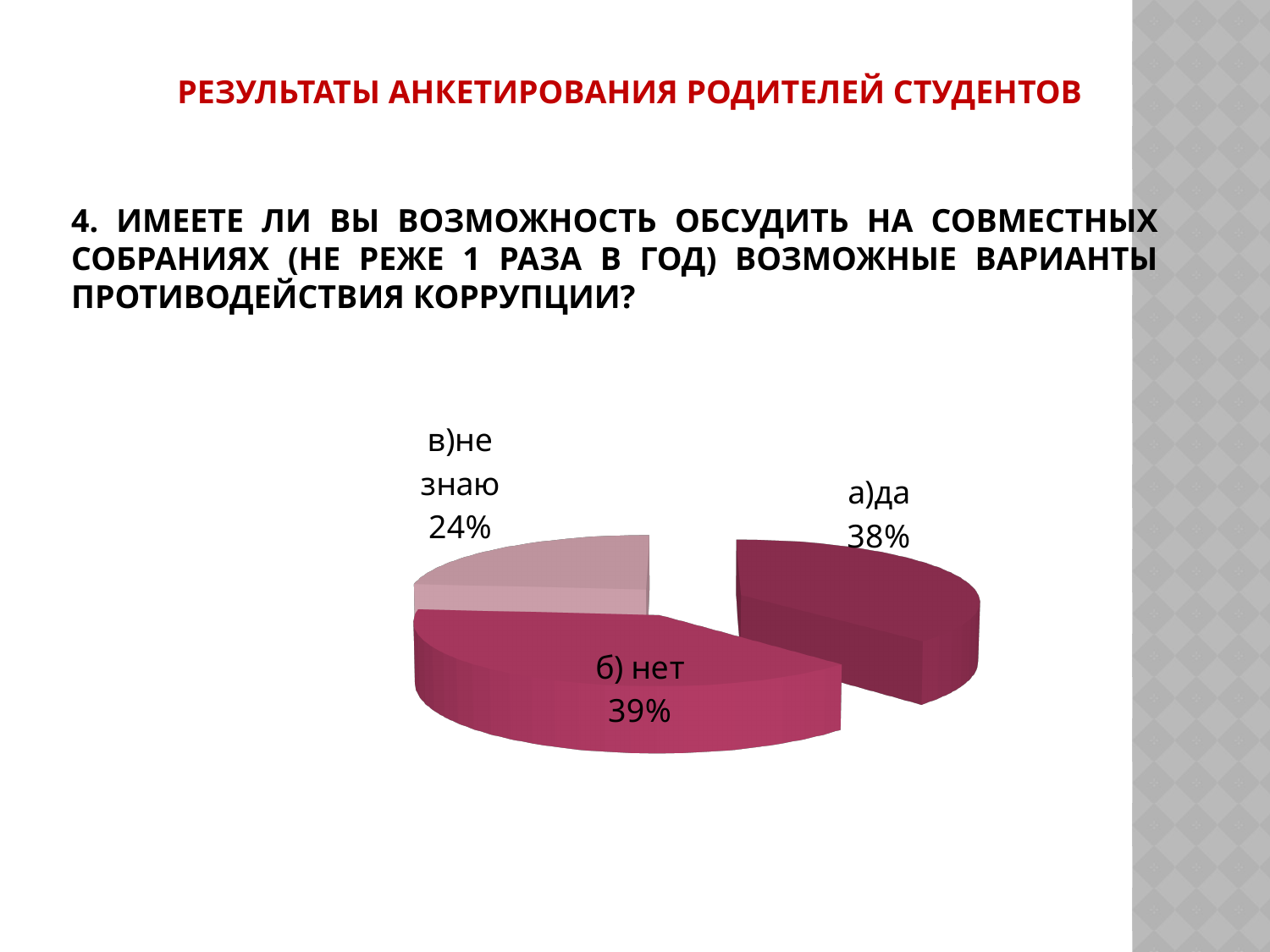
Which is larger: the share for "б) нет" or the share for "в)не знаю"? б) нет What is the difference in percentage points between "а)да" and "в)не знаю"? 14 What is the difference in percentage points between "б) нет" and "в)не знаю"? 15 Which answer option has the largest share of the pie? б) нет What is the share of the pie for the "а)да" slice? 38% How many slices does the pie chart have? 3 What type of chart is shown on the slide? Pie chart What percentage of respondents answered "а)да"? 38% Which answer option has the smallest share of the pie? в)не знаю What percentage of respondents answered "б) нет"? 39% What percentage of respondents answered "в)не знаю"? 24% Which slice of the pie is shown in the lightest pink colour? в)не знаю